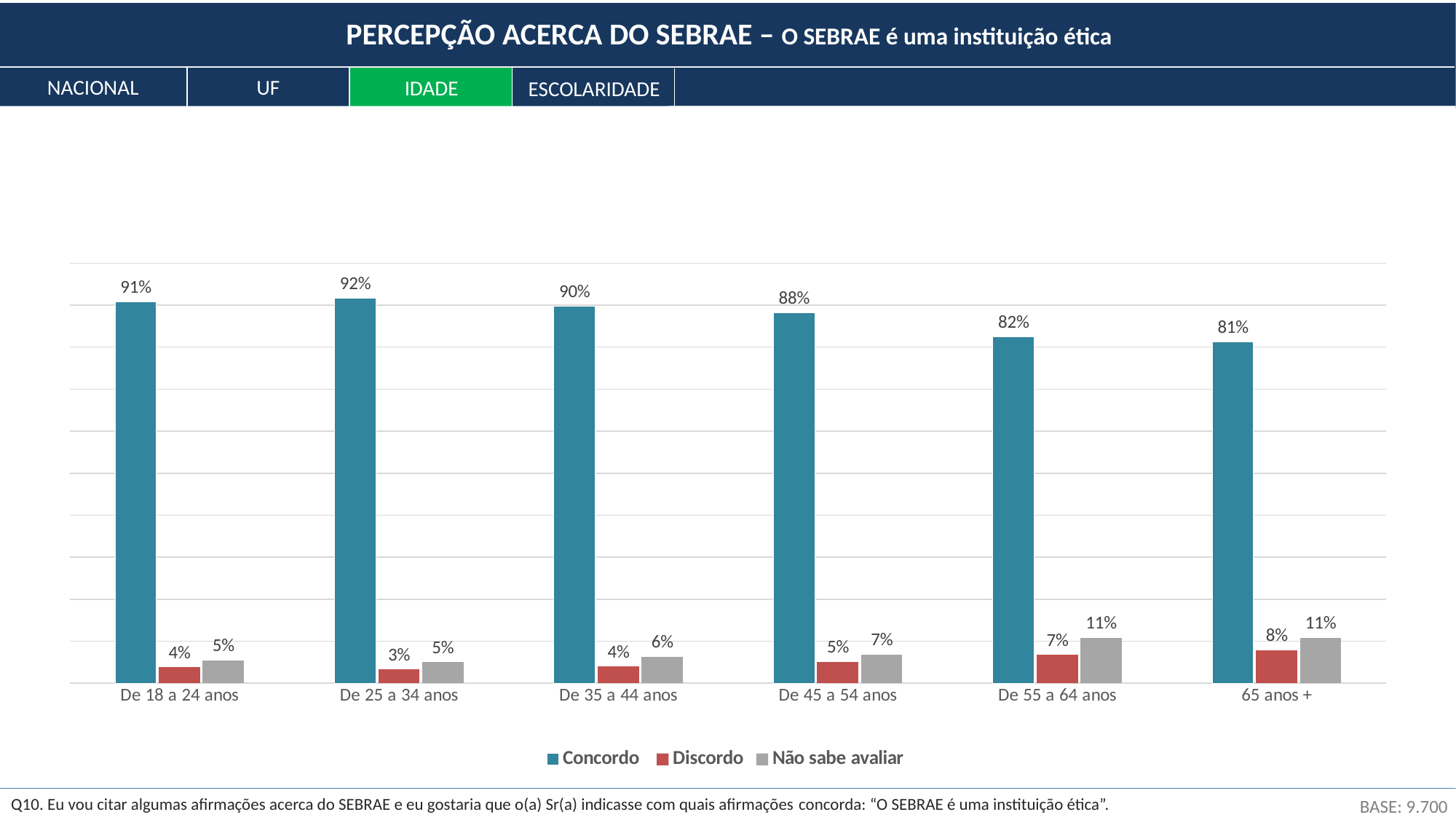
What is the Discordo value for 65 anos +? 8% How many series does the legend list? 3 Which legend entry is shown in red? Discordo What is the difference between the Concordo values for De 18 a 24 anos and De 55 a 64 anos? 9% What is the Não sabe avaliar value for De 45 a 54 anos? 7% Do the Não sabe avaliar values rise or fall from De 18 a 24 anos to 65 anos +? Rise How many age groups are shown on the x axis? 6 Which age group has the highest Concordo value? De 25 a 34 anos Which is larger, the Discordo value for De 35 a 44 anos or for De 55 a 64 anos? De 55 a 64 anos What is the Concordo value for De 25 a 34 anos? 92% What kind of chart is shown on the slide? Bar chart Which age group has the lowest Concordo value? 65 anos +